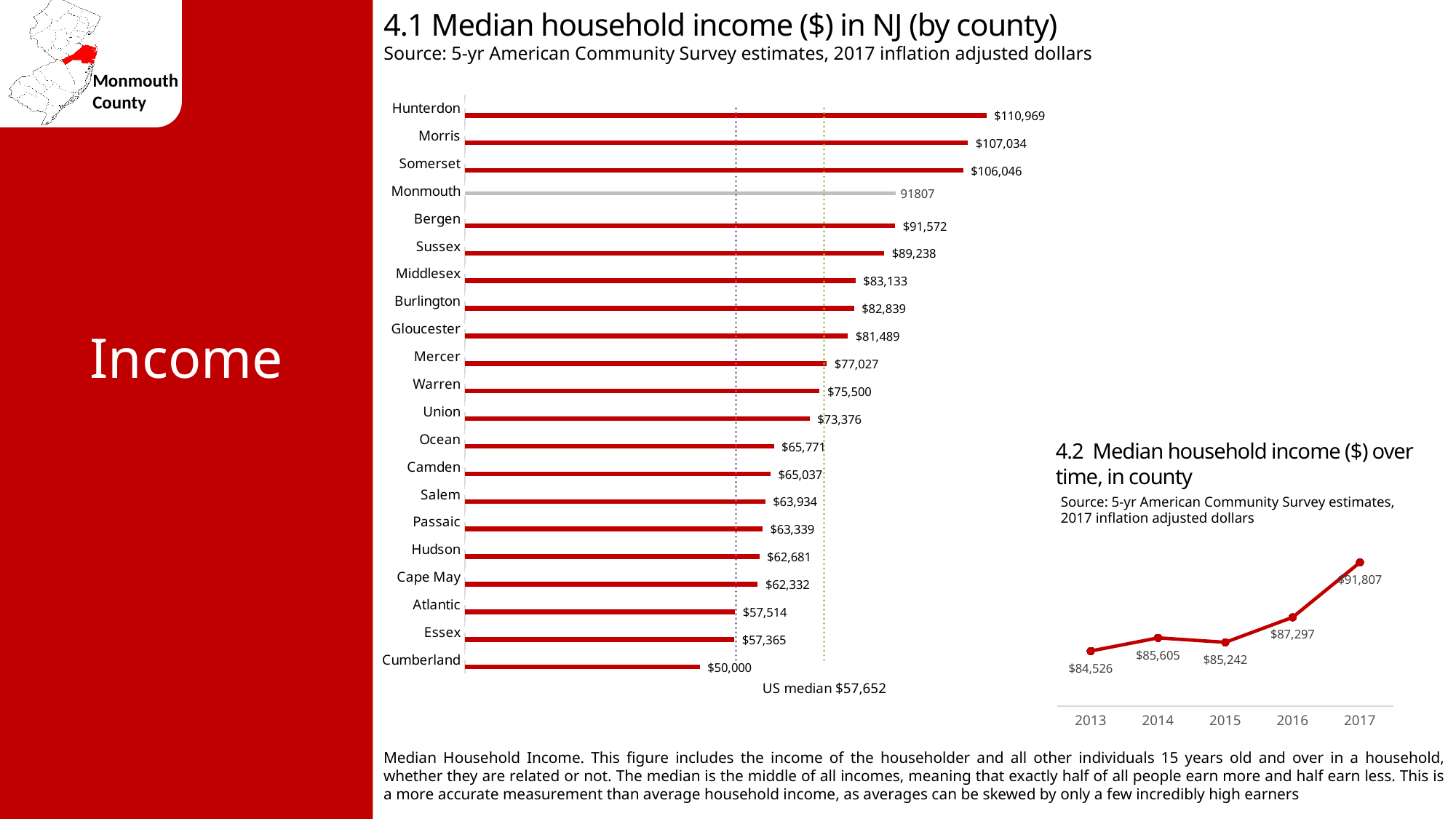
What kind of chart is '4.2 Median household income ($) over time, in county'? Line chart In the chart '4.1 Median household income ($) in NJ (by county)', which county has the highest median household income? Hunterdon What kind of chart is '4.1 Median household income ($) in NJ (by county)'? Bar chart In the chart '4.1 Median household income ($) in NJ (by county)', what is the value shown for Monmouth? 91807 In the chart '4.2 Median household income ($) over time, in county', what is the value for 2016? $87,297 In the chart '4.1 Median household income ($) in NJ (by county)', which has a higher median household income, Middlesex or Mercer? Middlesex In the chart '4.2 Median household income ($) over time, in county', which year has the lowest value? 2013 In the chart '4.1 Median household income ($) in NJ (by county)', how many counties are shown? 21 In the chart '4.2 Median household income ($) over time, in county', what is the difference between the 2017 and 2013 values? $7,281 In the chart '4.1 Median household income ($) in NJ (by county)', which county has the lowest median household income? Cumberland In the chart '4.1 Median household income ($) in NJ (by county)', what is the difference between the values for Hunterdon and Cumberland? $60,969 In the chart '4.1 Median household income ($) in NJ (by county)', what is the median household income for Bergen? $91,572